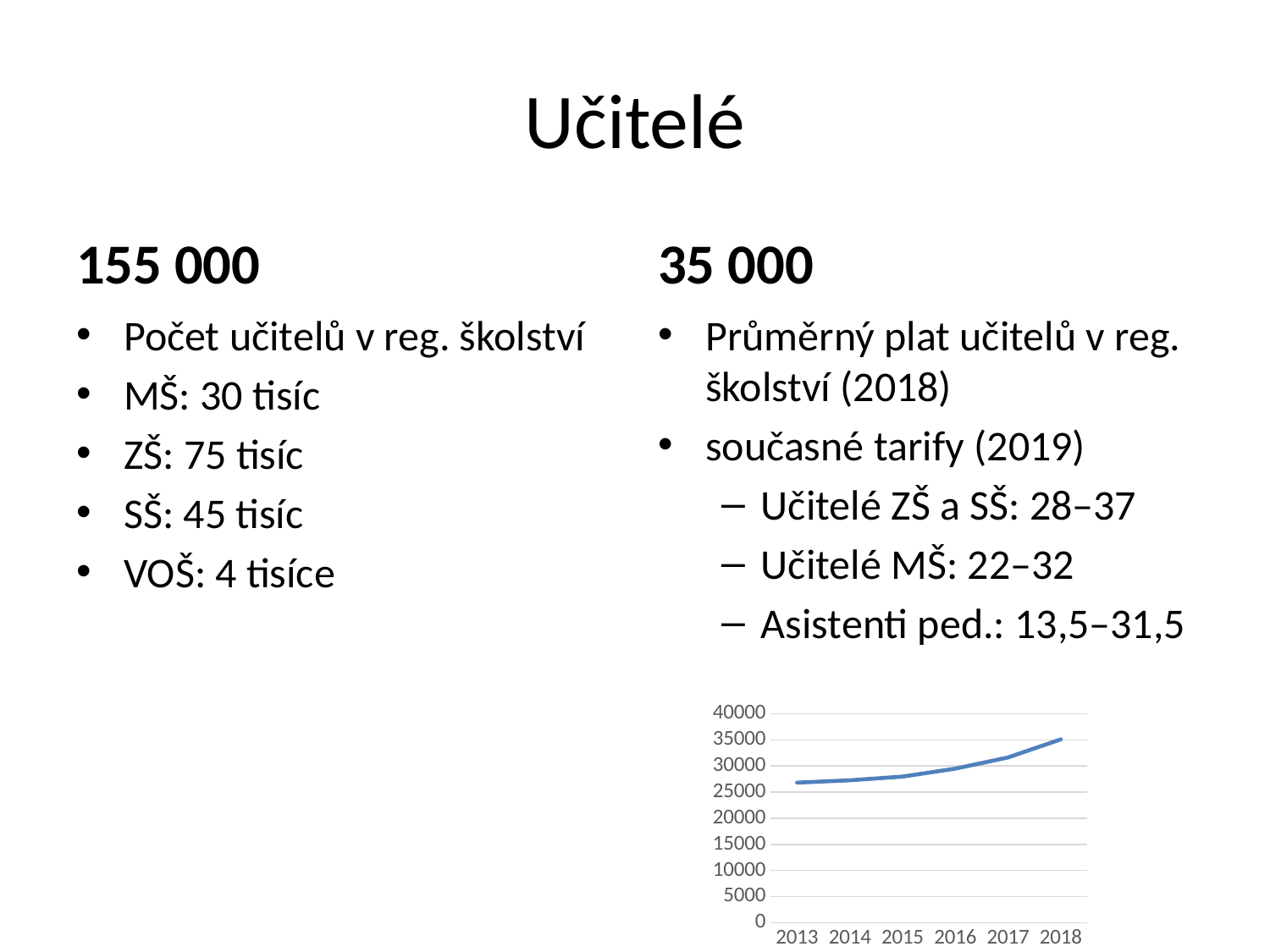
Is the value for 2017 greater or less than 30000? greater Which year has the highest value in the chart? 2018 Is the value for 2013 greater or less than 25000? greater Which year has the larger value in the chart, 2014 or 2017? 2017 How many years are plotted on the x axis of the chart? 6 Is the value for 2013 greater or less than 30000? less What kind of chart is shown at the bottom right of the slide? line chart Do the values in the chart rise or fall from 2013 to 2018? rise What is the highest value shown on the y axis of the chart? 40000 Which year has the lowest value in the chart? 2013